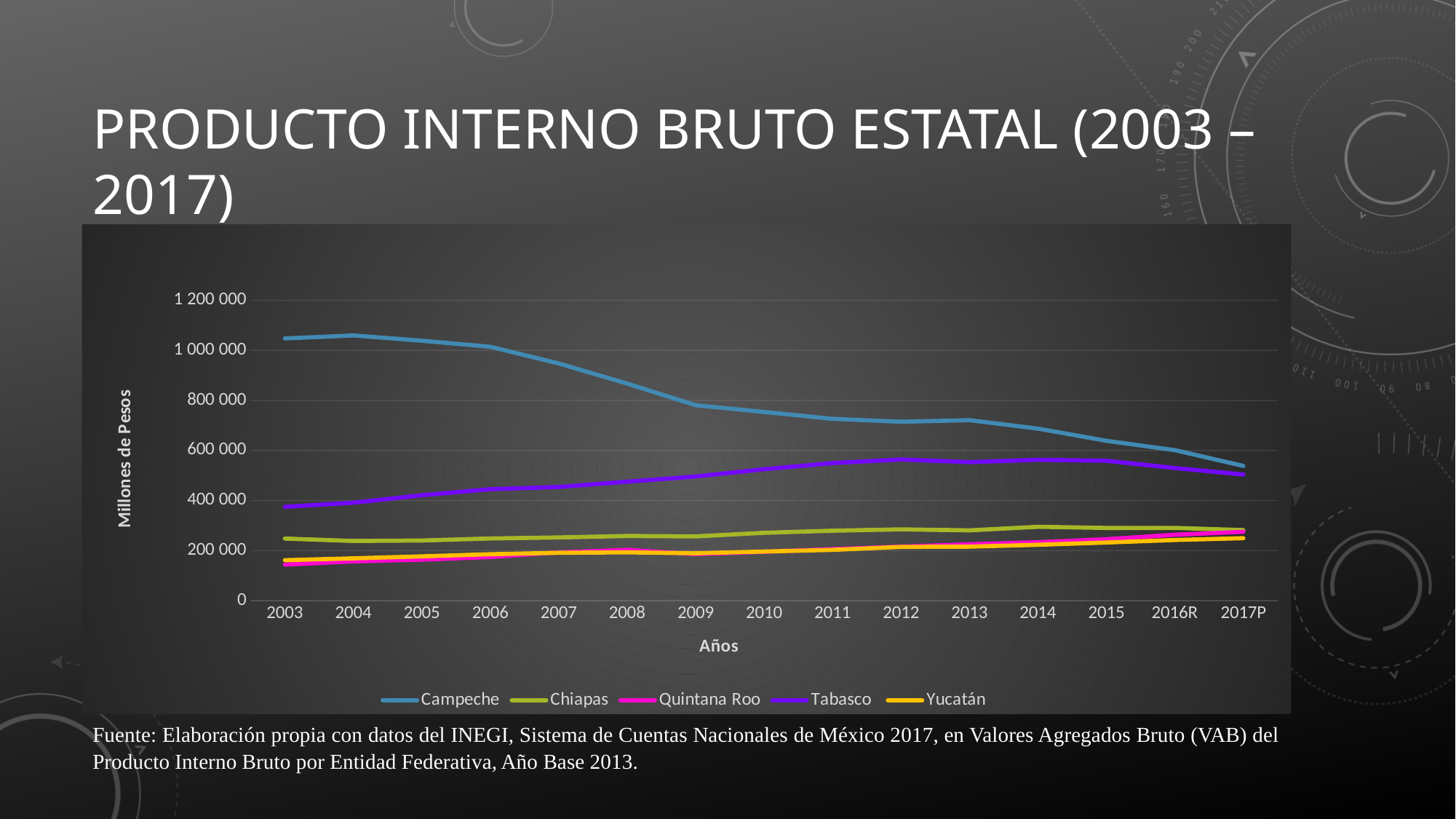
Does the value for Tabasco rise or fall from 2003 to 2012? rise Does the value for Campeche rise or fall from 2003 to 2017P? fall Is the value for Tabasco in 2012 greater or less than 400 000? greater Is the value for Campeche in 2003 greater or less than 1 000 000? greater How many series does the legend list? 5 Which is larger in 2010, the value for Chiapas or the value for Tabasco? Tabasco Which series has the highest value in 2003? Campeche What is the title of the vertical axis? Millones de Pesos Which is larger in 2017P, the value for Campeche or the value for Tabasco? Campeche What kind of chart is shown on the slide? line chart Is the value for Campeche in 2017P greater or less than 600 000? less How many years are shown along the x axis? 15